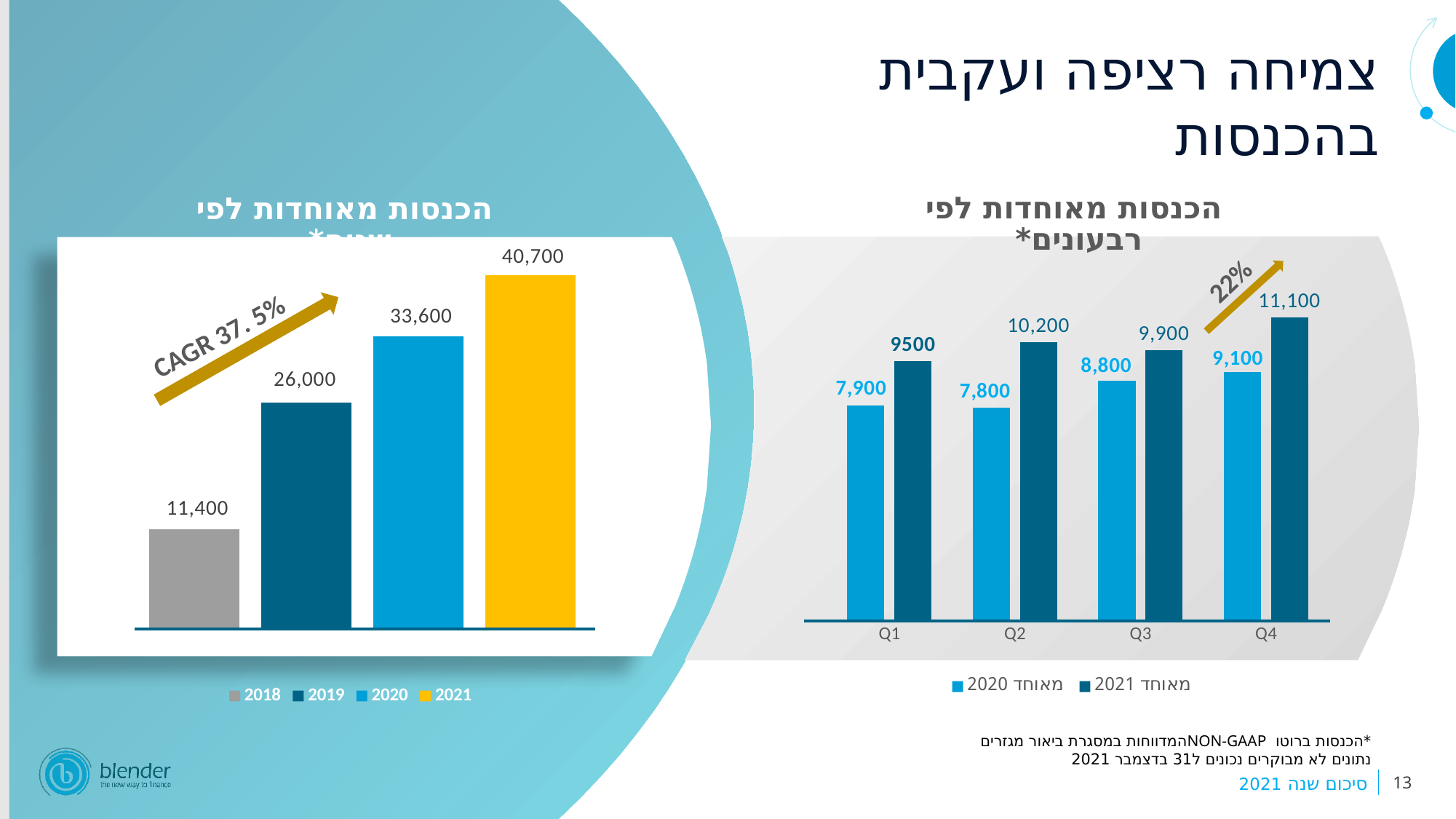
In the right chart, what is the 2020 value for Q4? 9,100 In the right chart, what is the difference between the 2021 and 2020 values for Q4? 2,000 In the left chart, do the values rise or fall from 2018 to 2021? rise In the left chart, what is the difference between the 2021 and 2020 values? 7,100 In the right chart, what is the 2021 value for Q2? 10,200 In the left chart, what is the value for 2021? 40,700 In the left chart, what is the value for 2018? 11,400 In the left chart, what CAGR is written next to the arrow? 37.5% What kind of chart is the right chart? bar chart In the right chart, which quarter has the lowest 2020 value? Q2 In the left chart, which year has the highest value? 2021 In the right chart, how many series does the legend list? 2